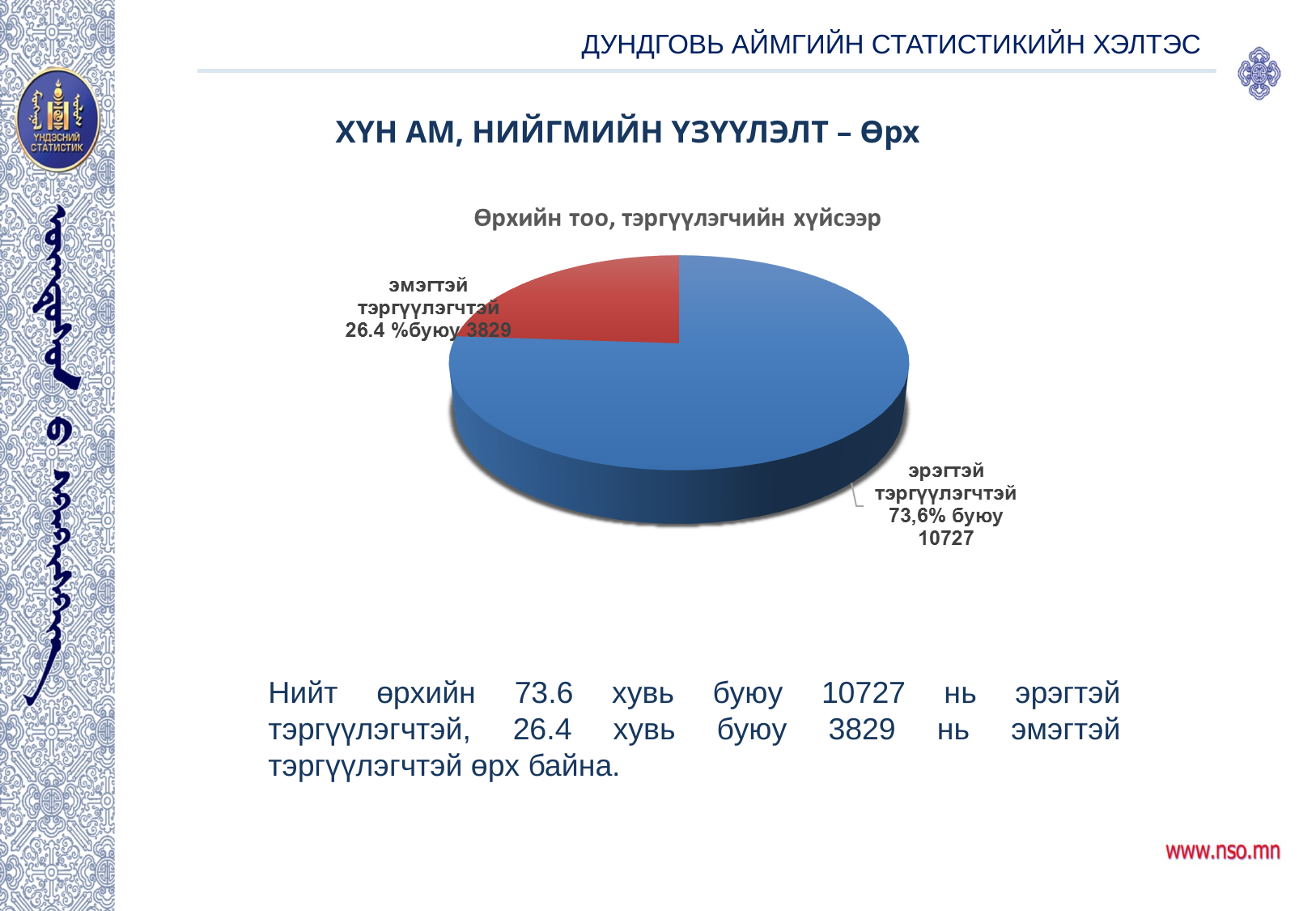
How many households are headed by a man (эрэгтэй тэргүүлэгчтэй) according to the chart? 10727 Which slice of the pie is the largest? эрэгтэй тэргүүлэгчтэй Which slice of the pie is the smallest? эмэгтэй тэргүүлэгчтэй How many slices does the pie chart have? 2 What share of the pie is the эрэгтэй тэргүүлэгчтэй slice? 73,6% What is the title of the chart? Өрхийн тоо, тэргүүлэгчийн хүйсээр What share of the pie is the эмэгтэй тэргүүлэгчтэй slice? 26.4 % What is the difference between the number of households headed by a man and those headed by a woman? 6898 What type of chart is shown on the slide? Pie chart Which is larger: the number of households headed by a man or by a woman? эрэгтэй тэргүүлэгчтэй (headed by a man) How many households are headed by a woman (эмэгтэй тэргүүлэгчтэй) according to the chart? 3829 What colour is the эмэгтэй тэргүүлэгчтэй slice? Red